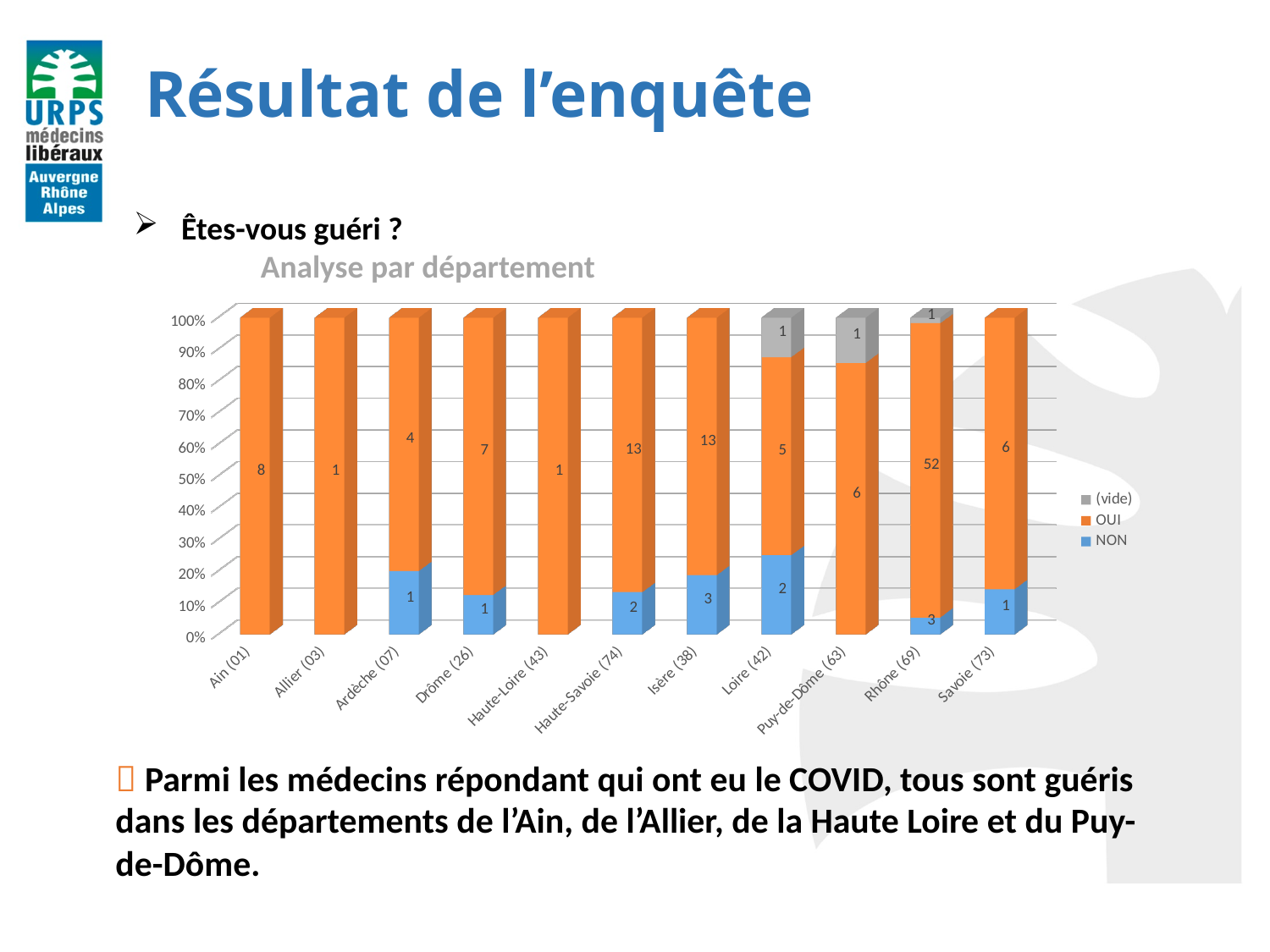
How many series does the chart legend list? 3 What is the OUI value for Rhône (69)? 52 What is the title of the chart? Analyse par département What is the (vide) value for Loire (42)? 1 What is the OUI value for Haute-Savoie (74)? 13 What is the NON value for Isère (38)? 3 What is the total number of responses in the Rhône (69) bar (NON + OUI + (vide))? 56 What is the difference between the OUI value for Ain (01) and the OUI value for Drôme (26)? 1 Which is larger: the OUI value for Ardèche (07) or the OUI value for Savoie (73)? Savoie (73) What type of chart is shown on the slide? stacked bar chart How many departments (categories) are shown on the x axis of the chart? 11 Which department has the highest OUI value? Rhône (69)